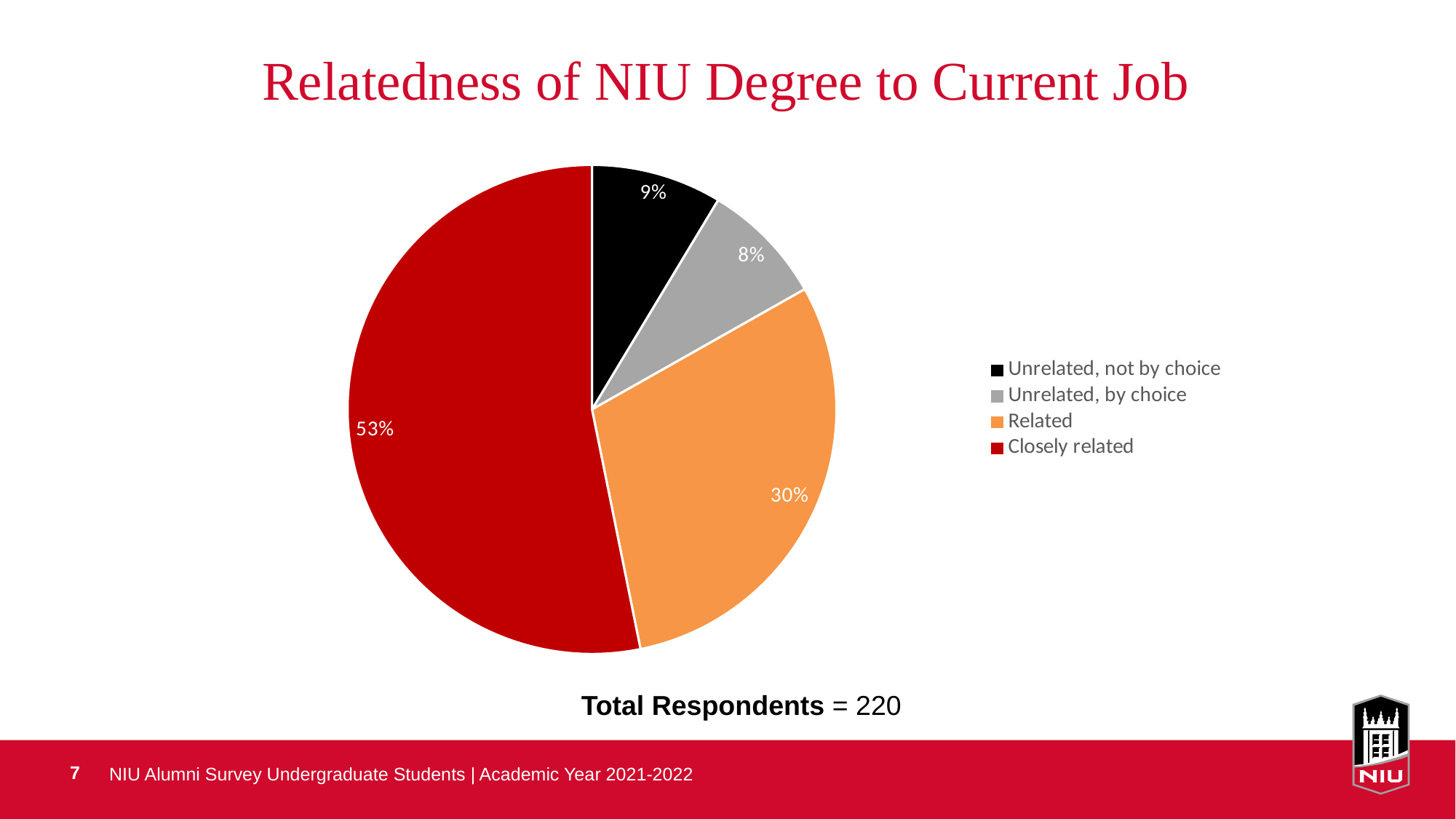
What percentage of respondents said their job is unrelated, not by choice? 9% What percentage of respondents said their job is related to their NIU degree? 30% What is the total number of respondents stated on the slide? 220 Which category has the largest share of the pie? Closely related Which is larger: the share for Unrelated, not by choice or the share for Unrelated, by choice? Unrelated, not by choice Which category has the smallest share of the pie? Unrelated, by choice What type of chart is shown on the slide? Pie chart What colour is the slice for Related? Orange What percentage of respondents said their job is unrelated, by choice? 8% How many categories are shown in the pie chart? 4 What is the difference in percentage points between Closely related and Related? 23 What percentage of respondents said their job is closely related to their NIU degree? 53%